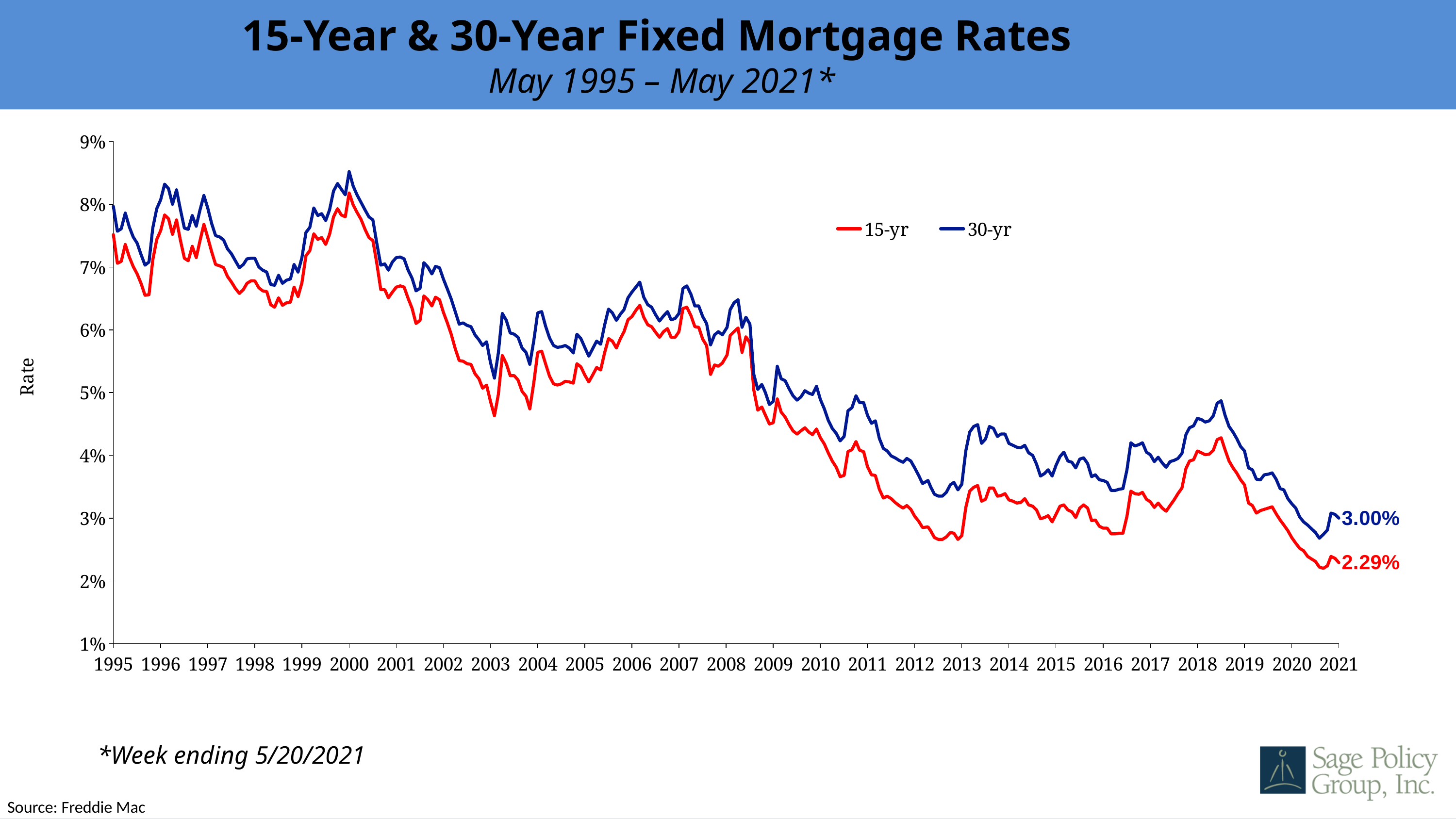
What is the difference between the final 30-yr rate and the final 15-yr rate in May 2021? 0.71% Is the 30-yr rate in 2006 greater or less than 6%? greater Is the 30-yr rate at the start of 2000 greater or less than 8%? greater Which series ends higher in May 2021, 15-yr or 30-yr? 30-yr How many series does the legend list? 2 What is the source cited for the chart data? Freddie Mac Is the 15-yr rate in 2013 greater or less than 4%? less Overall, do mortgage rates rise or fall from 1995 to 2021? Fall What is the final value shown for the 30-yr series in May 2021? 3.00% What kind of chart is shown on the slide? Line chart What is the final value shown for the 15-yr series in May 2021? 2.29% What colour is the line for the 15-yr series? Red